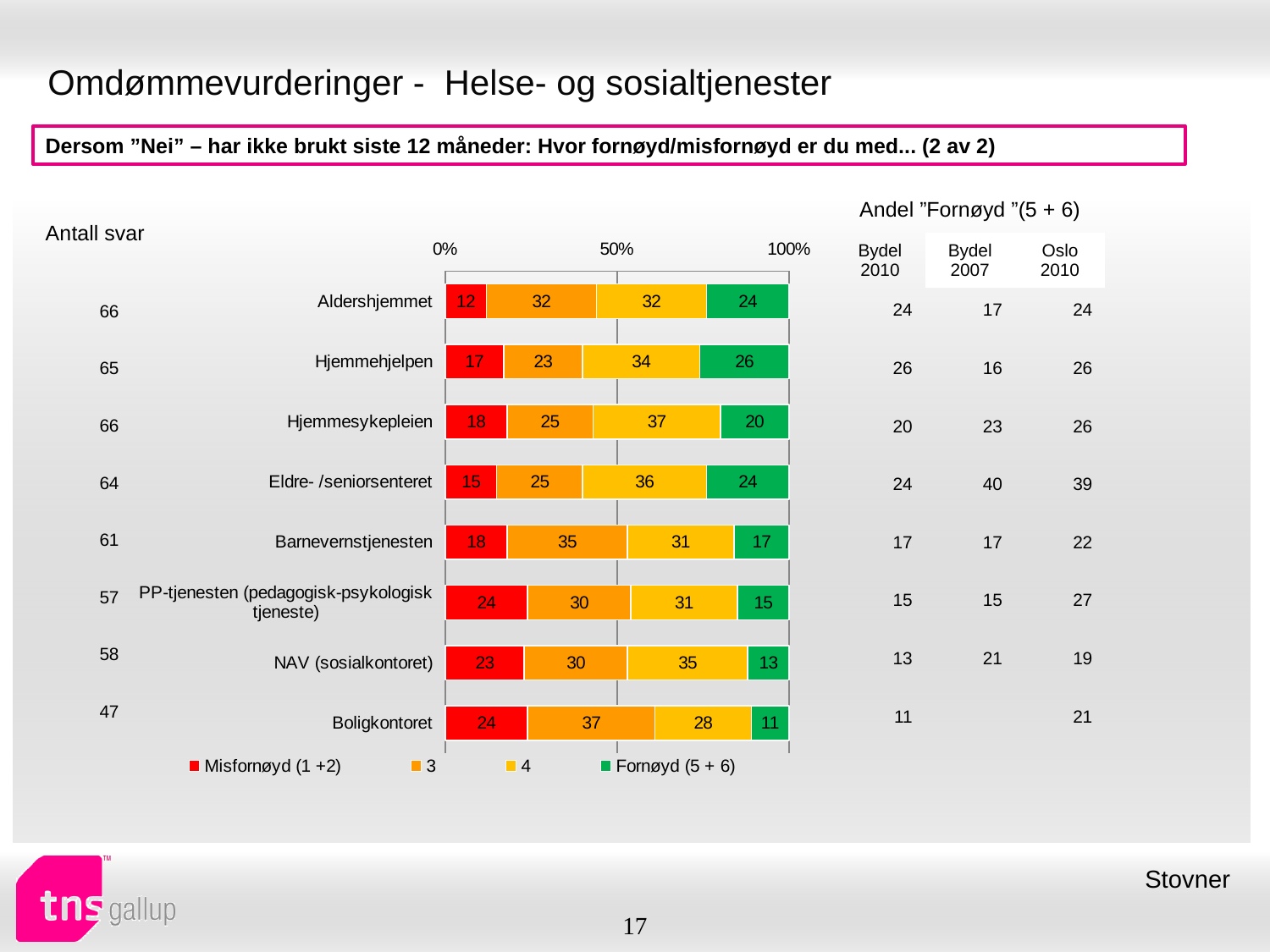
What is the difference between the "Fornøyd (5 + 6)" values for Hjemmehjelpen and NAV (sosialkontoret)? 13 What is the "Fornøyd (5 + 6)" value for Hjemmesykepleien? 20 What kind of chart is shown on the slide? stacked bar chart How many series does the chart legend list? 4 What is the "Misfornøyd (1 +2)" value for Aldershjemmet? 12 How many service categories are plotted in the chart? 8 Which is larger: the "Misfornøyd (1 +2)" value for NAV (sosialkontoret) or for Eldre- /seniorsenteret? NAV (sosialkontoret) What is the total of the stacked bar for Barnevernstjenesten? 101 Which category has the highest "Fornøyd (5 + 6)" value? Hjemmehjelpen Which category has the lowest "Misfornøyd (1 +2)" value? Aldershjemmet Which category has the lowest "Fornøyd (5 + 6)" value? Boligkontoret What is the value of series "3" for Boligkontoret? 37